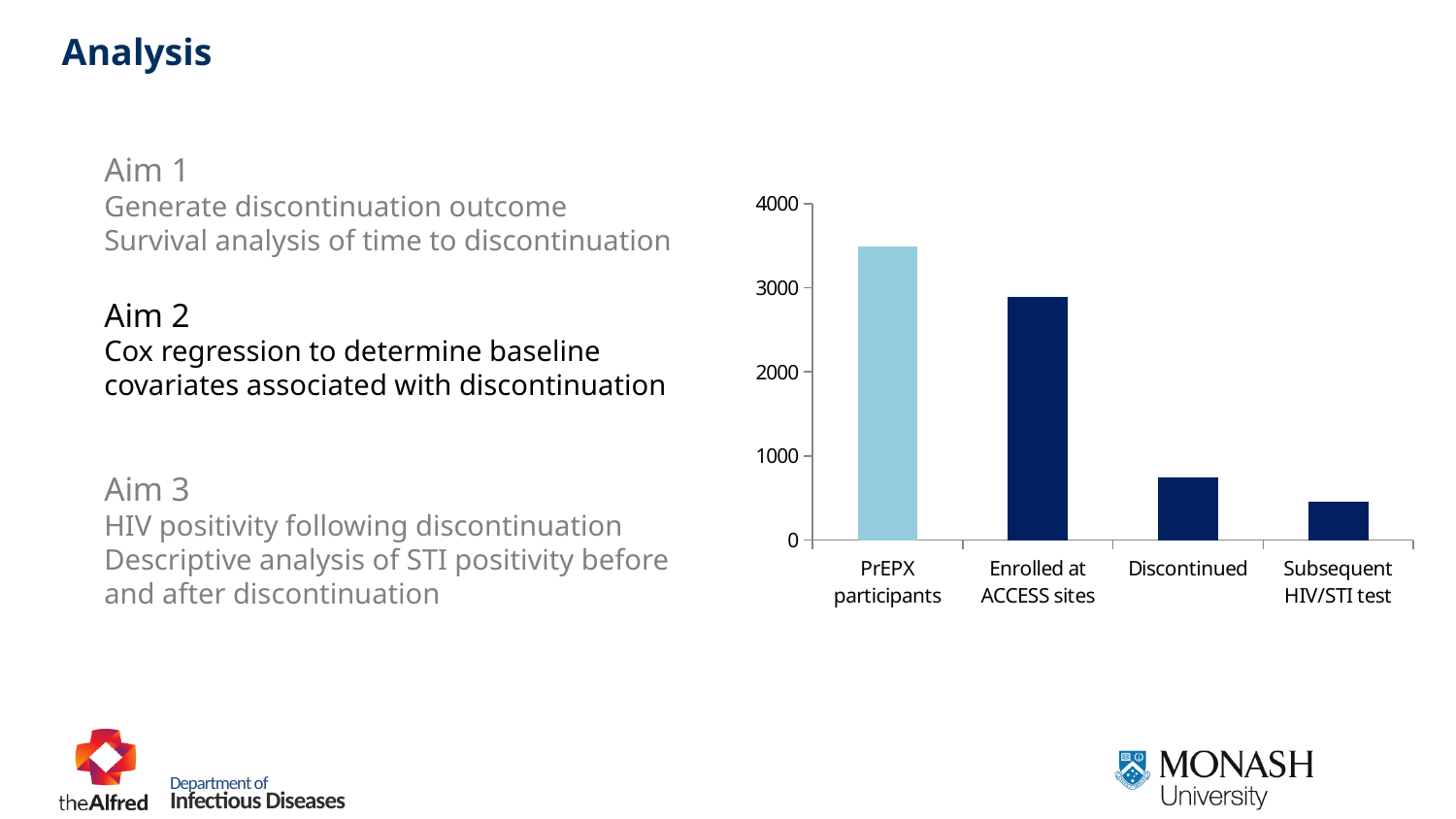
How many categories are shown on the x axis of the chart? 4 Is the value for Enrolled at ACCESS sites greater or less than 3000? less What is the highest value labelled on the vertical axis of the chart? 4000 Do the bar values rise or fall from left to right along the x axis? fall Is the value for PrEPX participants greater or less than 3000? greater Which category has the highest bar in the chart? PrEPX participants Which is larger, the value for Enrolled at ACCESS sites or the value for Discontinued? Enrolled at ACCESS sites Is the value for Discontinued greater or less than 1000? less Which category has the lowest bar in the chart? Subsequent HIV/STI test What kind of chart is shown on the slide? bar chart Which bar in the chart is coloured light blue rather than dark navy? PrEPX participants